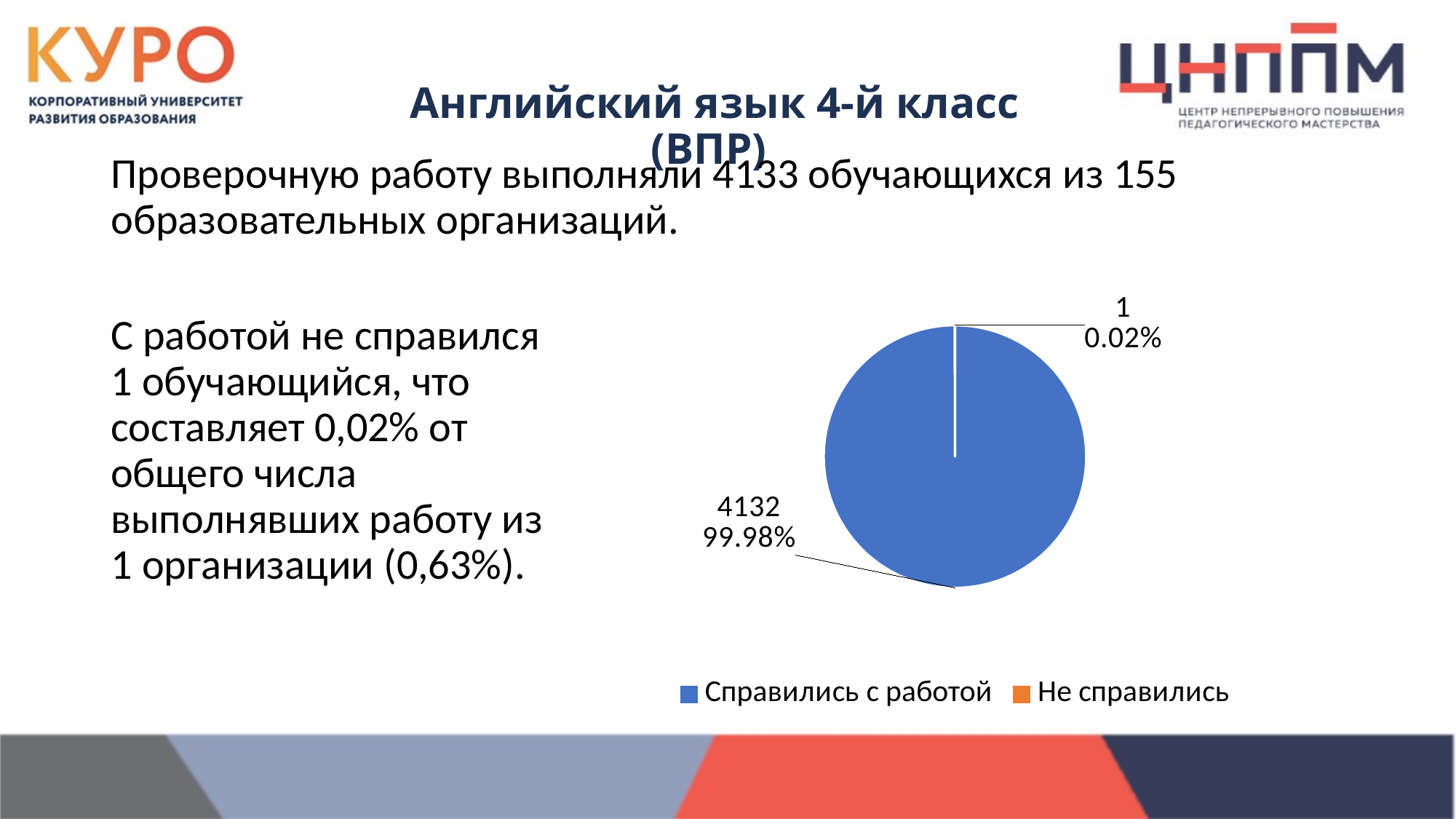
What is the value for 'Справились с работой'? 4132 What is the value for 'Не справились'? 1 What is the difference between the values for 'Справились с работой' and 'Не справились'? 4131 What share of the pie does 'Не справились' represent? 0.02% How many entries does the chart legend list? 2 What is the total of the two slices in the pie chart? 4133 What kind of chart is shown on the slide? pie chart Which category has the largest slice? Справились с работой How many slices does the pie chart have? 2 What share of the pie does 'Справились с работой' represent? 99.98% Which category has the smallest slice? Не справились Which colour represents 'Справились с работой' in the legend? blue